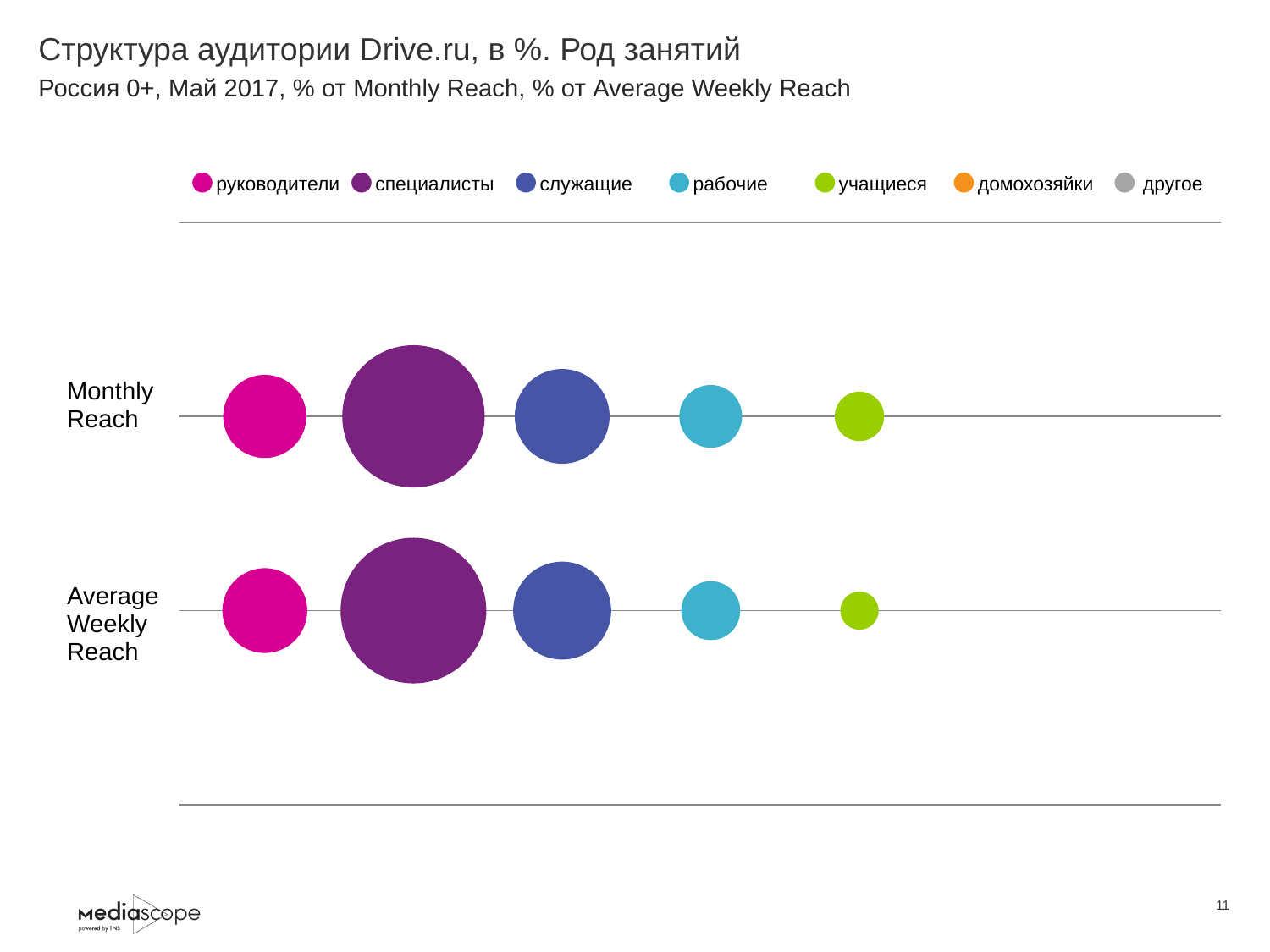
What is the title of the chart on the slide? Структура аудитории Drive.ru, в %. Род занятий Which occupation group has the largest bubble in the Monthly Reach row? специалисты In the Monthly Reach row, which bubble is larger: рабочие or учащиеся? рабочие Which occupation group has the largest bubble in the Average Weekly Reach row? специалисты How many occupation categories does the legend list? 7 Among the bubbles visible in the Monthly Reach row, which occupation group has the smallest? учащиеся Among the bubbles visible in the Average Weekly Reach row, which occupation group has the smallest? учащиеся What kind of chart is shown on the slide? bubble chart How many rows (reach measures) are plotted on the chart? 2 In the Average Weekly Reach row, which bubble is larger: служащие or рабочие? служащие Which occupation group is shown in orange in the legend? домохозяйки In the Monthly Reach row, which bubble is larger: специалисты or руководители? специалисты